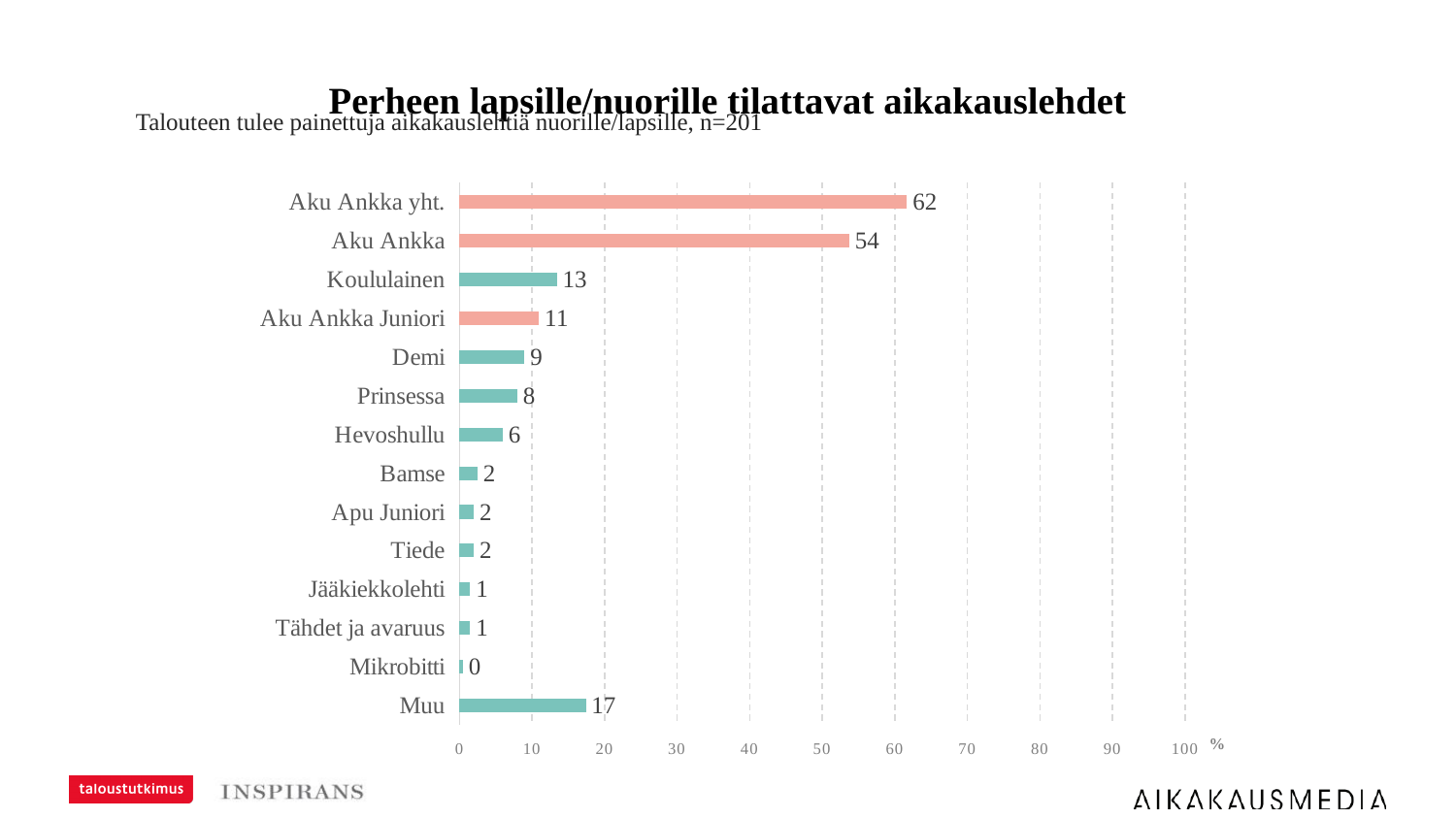
What is the difference between the values for Muu and Koululainen? 4 What is the value for Aku Ankka yht.? 62 What is the title of the chart? Perheen lapsille/nuorille tilattavat aikakauslehdet What is the difference between the values for Aku Ankka yht. and Aku Ankka? 8 What is the value for Hevoshullu? 6 What is the value for Muu? 17 What is the value for Koululainen? 13 What kind of chart is shown on the slide? Bar chart Which category has the lowest value? Mikrobitti Which category has the highest value? Aku Ankka yht. How many categories are shown on the chart? 14 Which is larger, the value for Demi or the value for Aku Ankka Juniori? Aku Ankka Juniori